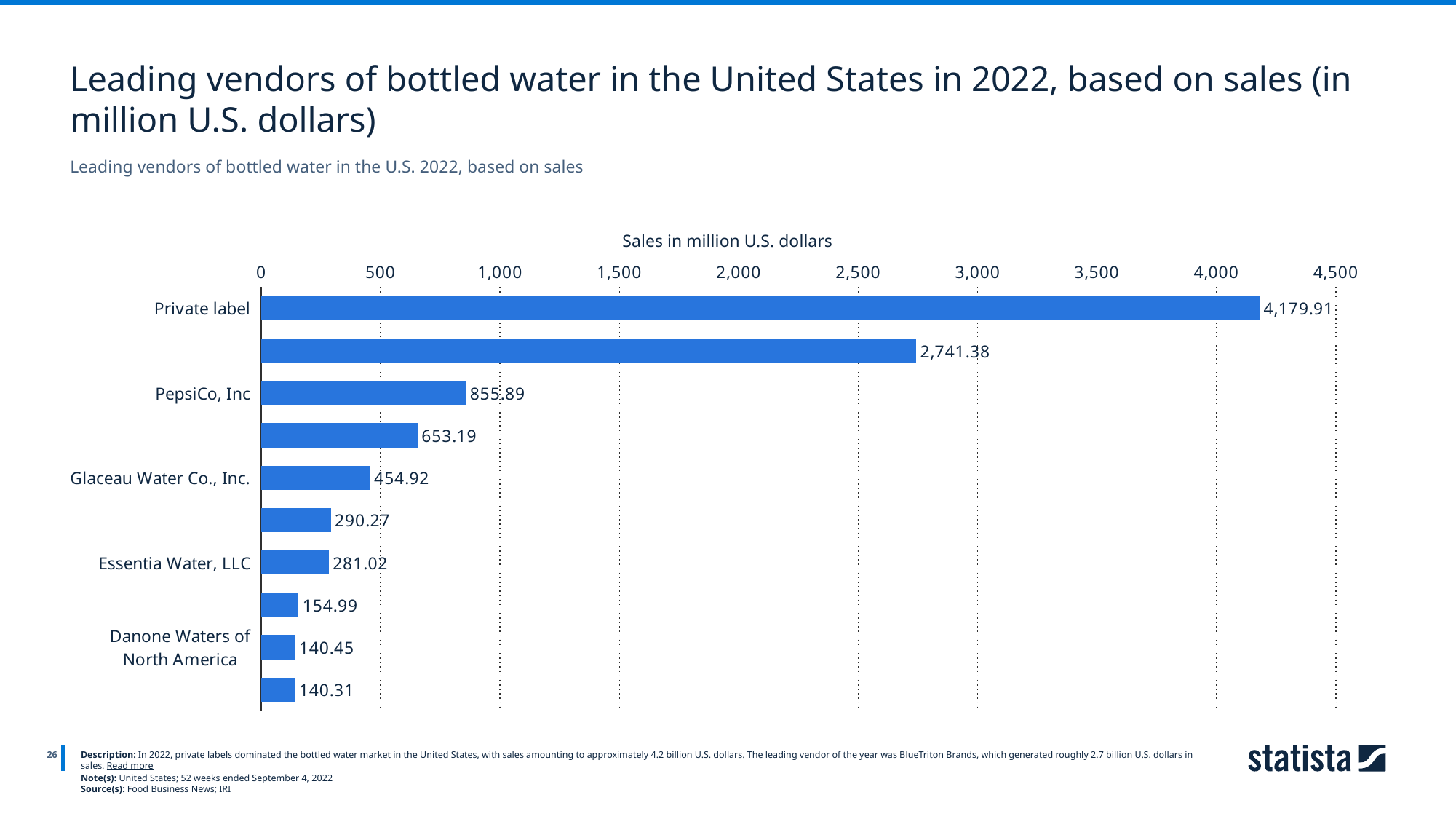
What is the difference in sales between Private label and PepsiCo, Inc? 3,324.02 Which vendor has the highest sales? Private label What are the sales for PepsiCo, Inc? 855.89 What is the value of the smallest bar in the chart? 140.31 What are the sales for Private label? 4,179.91 What are the sales for Essentia Water, LLC? 281.02 Which has higher sales, Glaceau Water Co., Inc. or Essentia Water, LLC? Glaceau Water Co., Inc. What are the sales for Danone Waters of North America? 140.45 How many bars are plotted in the chart? 10 What kind of chart is shown on the slide? Bar chart What are the sales for Glaceau Water Co., Inc.? 454.92 Is the value for Essentia Water, LLC greater or less than 500? less